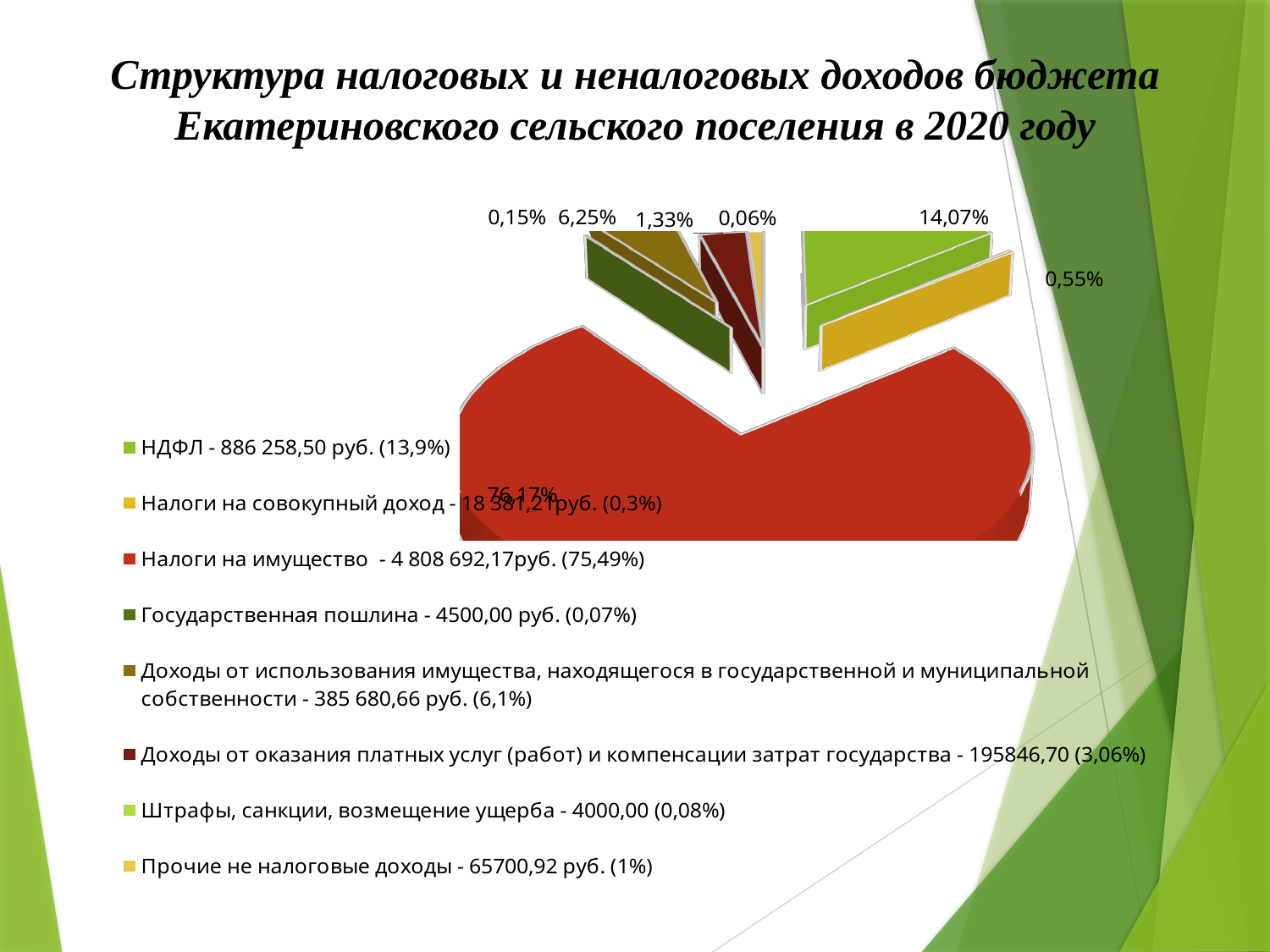
Which category has the largest slice of the pie chart? Налоги на имущество What is the difference between the НДФЛ slice (14,07%) and the Налоги на совокупный доход slice (0,55%)? 13,52% What amount in rubles does the legend give for НДФЛ? 886 258,50 руб. Which slice is larger: НДФЛ or Налоги на совокупный доход? НДФЛ What kind of chart is shown on the slide? pie chart What percentage is shown on the pie chart for the Налоги на совокупный доход slice? 0,55% Does the Налоги на имущество slice take up more or less than half of the pie? more How many categories does the legend of the pie chart list? 8 Which slice is larger: Налоги на имущество or НДФЛ? Налоги на имущество What is the title of the chart on the slide? Структура налоговых и неналоговых доходов бюджета Екатериновского сельского поселения в 2020 году What percentage is shown on the pie chart for the НДФЛ slice? 14,07%